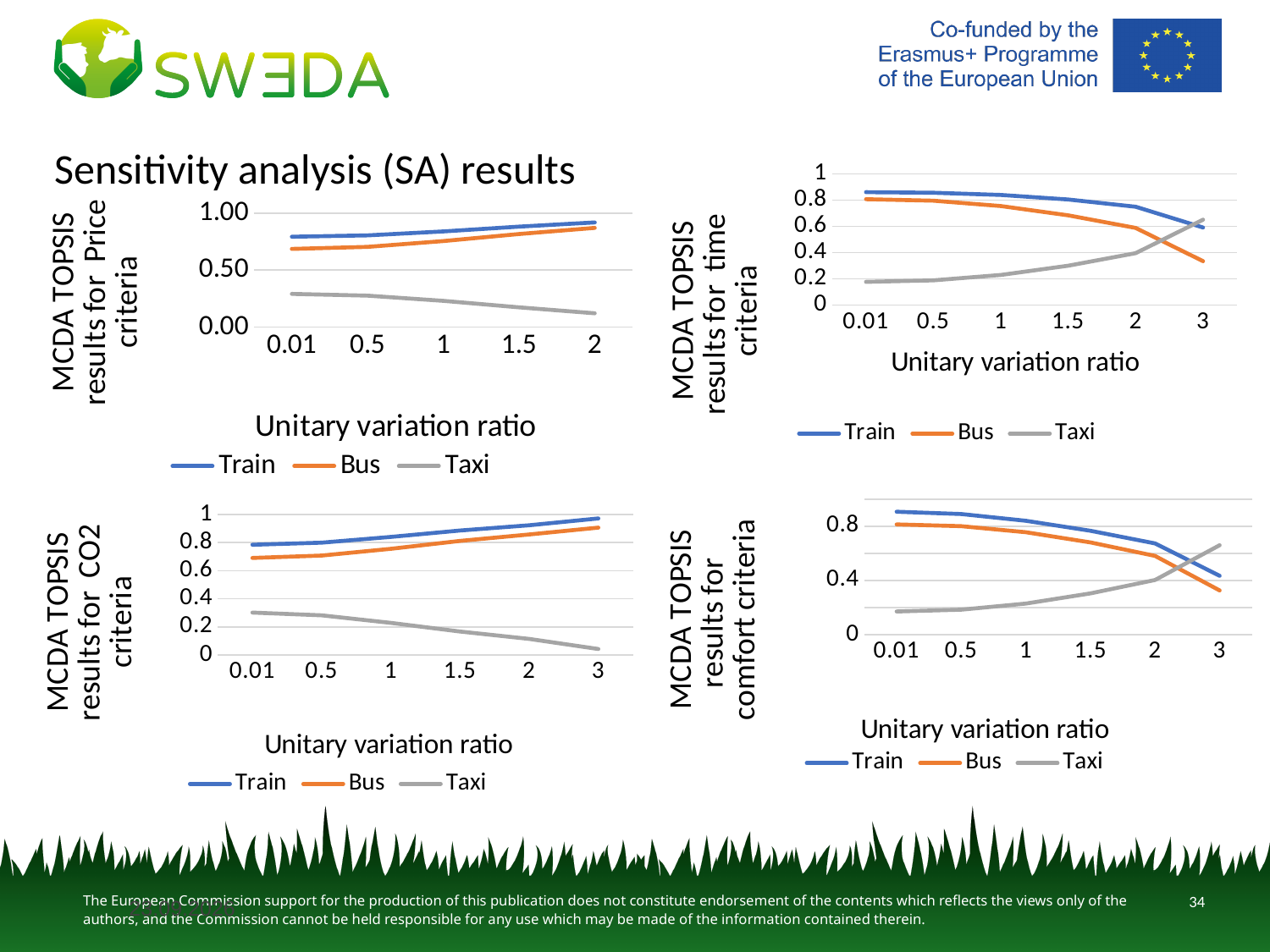
In the 'MCDA TOPSIS results for CO2 criteria' chart, which is higher at a unitary variation ratio of 0.01, Train or Taxi? Train In the 'MCDA TOPSIS results for Price criteria' chart, how many unitary variation ratio values are shown on the x axis? 5 In the 'MCDA TOPSIS results for time criteria' chart, is the Bus value at a unitary variation ratio of 3 greater or less than 0.4? less In the 'MCDA TOPSIS results for Price criteria' chart, how many series does the legend list? 3 In the 'MCDA TOPSIS results for time criteria' chart, how many unitary variation ratio values are shown on the x axis? 6 In the 'MCDA TOPSIS results for Price criteria' chart, does the Taxi line rise or fall as the unitary variation ratio increases? Fall In the 'MCDA TOPSIS results for comfort criteria' chart, which is higher at a unitary variation ratio of 3, Taxi or Bus? Taxi In the 'MCDA TOPSIS results for Price criteria' chart, is the Taxi value at a unitary variation ratio of 0.01 greater or less than 0.50? less What kind of chart is the 'MCDA TOPSIS results for Price criteria' chart? Line chart What is the x-axis title of the 'MCDA TOPSIS results for comfort criteria' chart? Unitary variation ratio In the 'MCDA TOPSIS results for comfort criteria' chart, does the Train line rise or fall as the unitary variation ratio increases? Fall In the 'MCDA TOPSIS results for time criteria' chart, does the Taxi line rise or fall as the unitary variation ratio increases? Rise